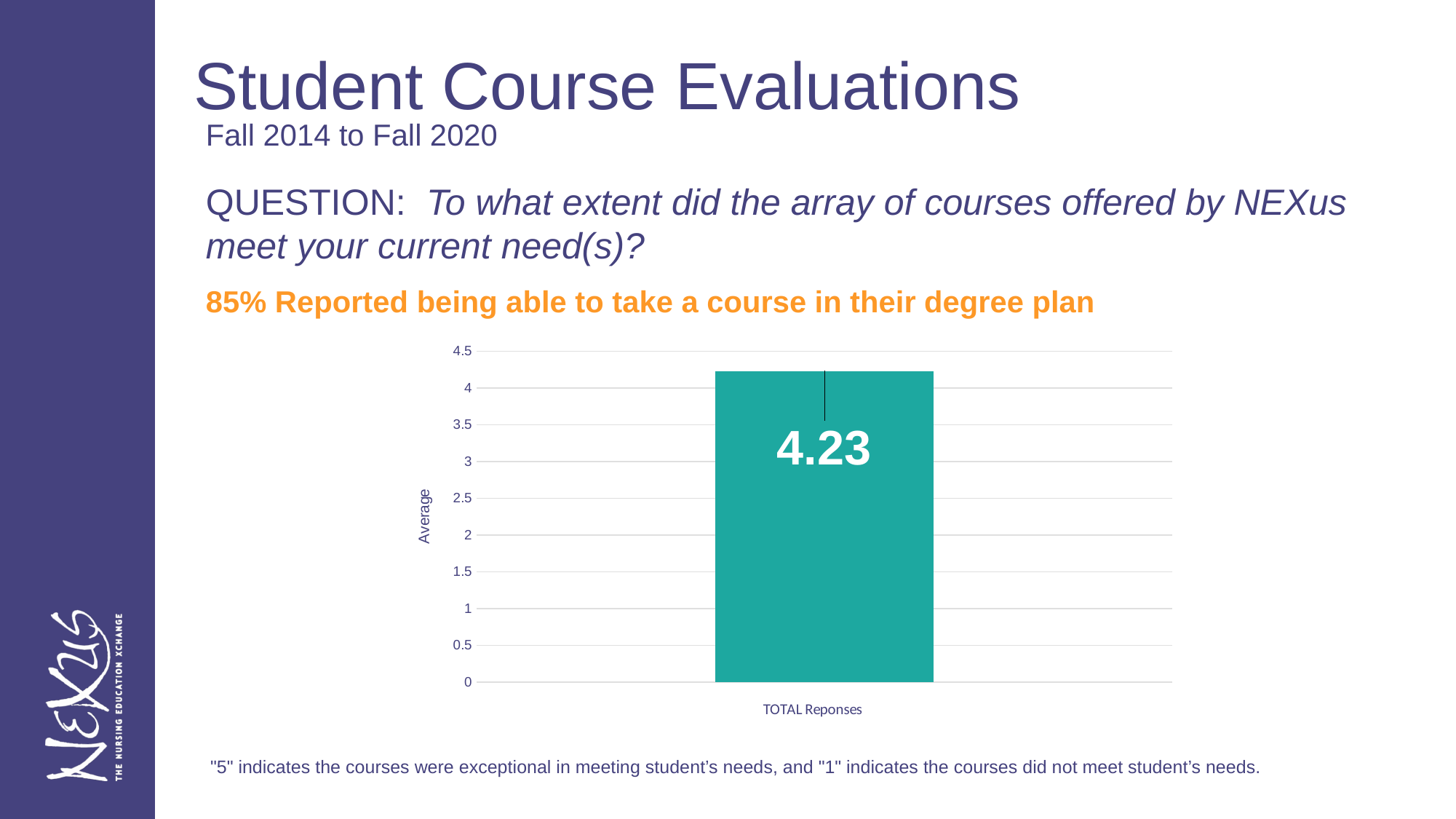
Is the value for TOTAL Reponses greater or less than 4.5? less How many bars does the chart have? 1 What is the category label shown under the bar? TOTAL Reponses Is the value for TOTAL Reponses greater or less than 4? greater What is the label on the vertical axis of the chart? Average What kind of chart is shown on the slide? bar chart What is the value shown for TOTAL Reponses? 4.23 What is the highest value shown on the vertical axis? 4.5